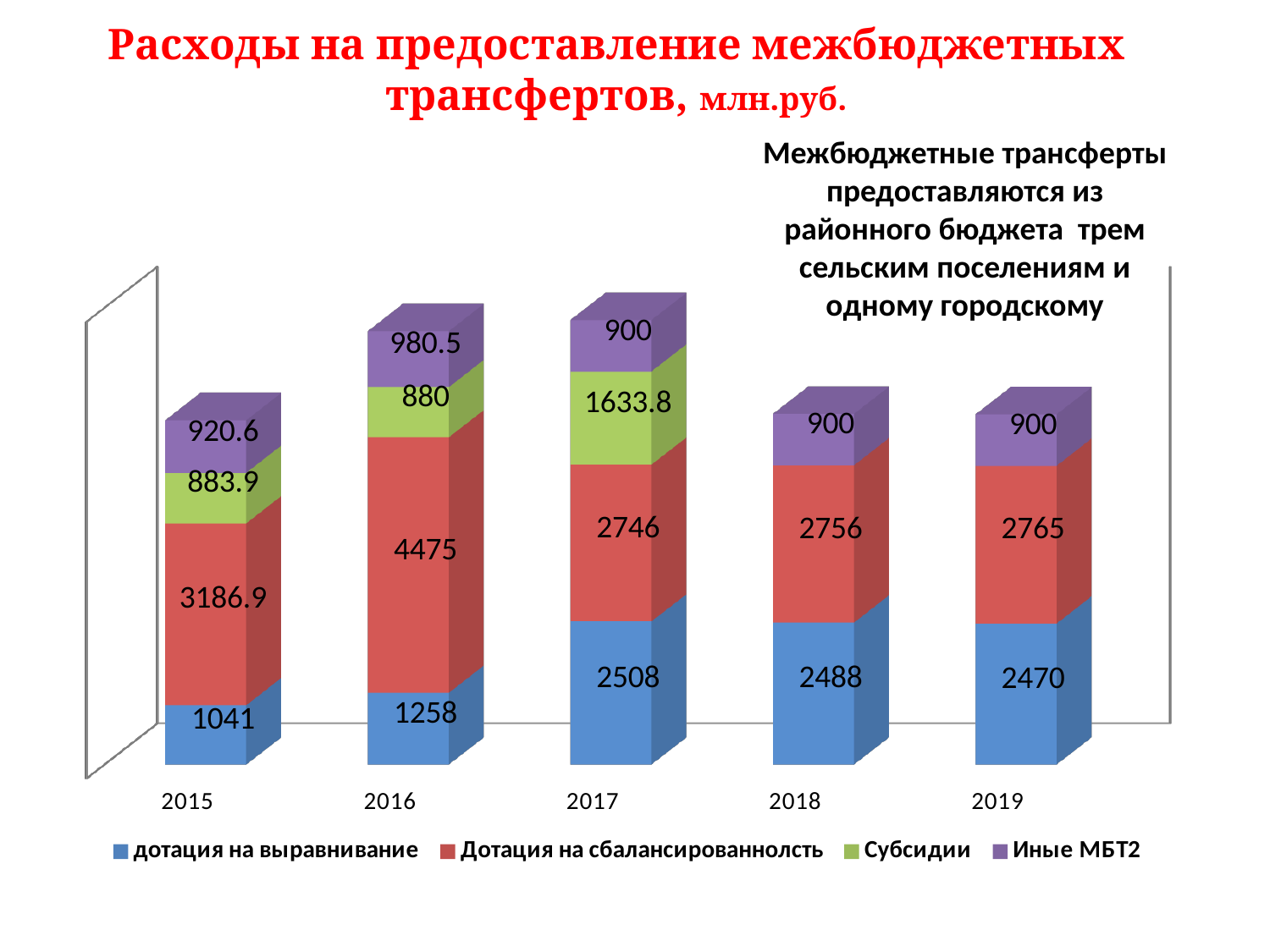
How many series does the legend list? 4 In which year is Дотация на сбалансированность the highest? 2016 What is the value of дотация на выравнивание for 2016? 1258 What is the value of Иные МБТ2 for 2015? 920.6 What is the total of the stacked bar for 2017? 7787.8 Does дотация на выравнивание rise or fall from 2017 to 2019? Fall How many years are shown on the x axis? 5 What kind of chart is shown on the slide? Stacked bar chart What is the value of Субсидии for 2017? 1633.8 In which year is дотация на выравнивание the lowest? 2015 Which year has the larger value for дотация на выравнивание, 2017 or 2018? 2017 What is the difference between Дотация на сбалансированность in 2016 and in 2015? 1288.1